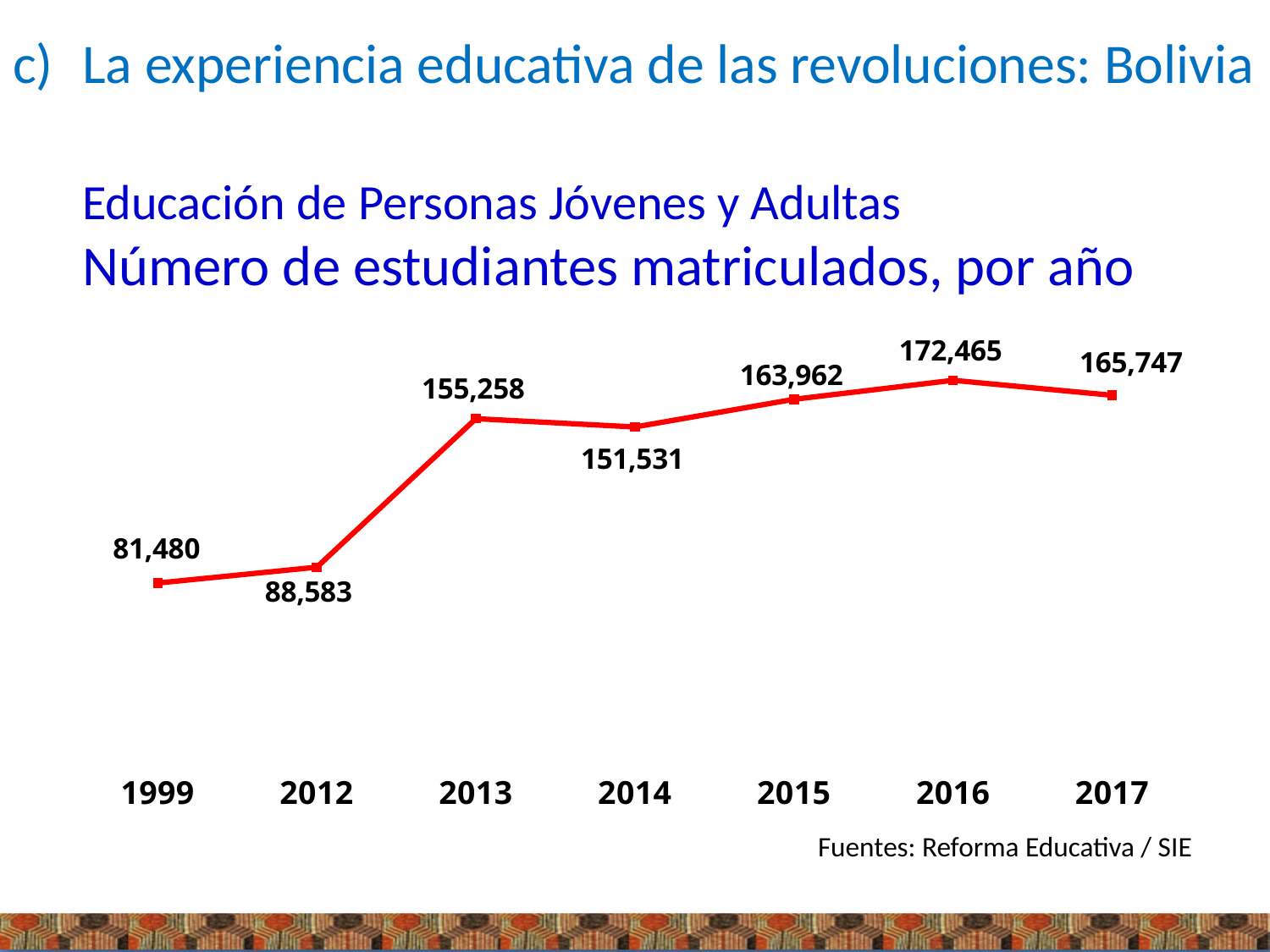
Which year had more enrolled students, 2013 or 2014? 2013 What was the number of students enrolled in 2017? 165,747 Do the values generally rise or fall from 1999 to 2016? Rise What is the difference in enrolled students between 2013 and 1999? 73,778 What was the number of students enrolled in 2013? 155,258 What source is cited below the chart? Reforma Educativa / SIE Which year has the highest number of enrolled students? 2016 How many years are plotted on the chart? 7 What is the difference in enrolled students between 2016 and 2017? 6,718 What was the number of students enrolled in 1999? 81,480 What kind of chart is shown on the slide? Line chart Which year has the lowest number of enrolled students? 1999